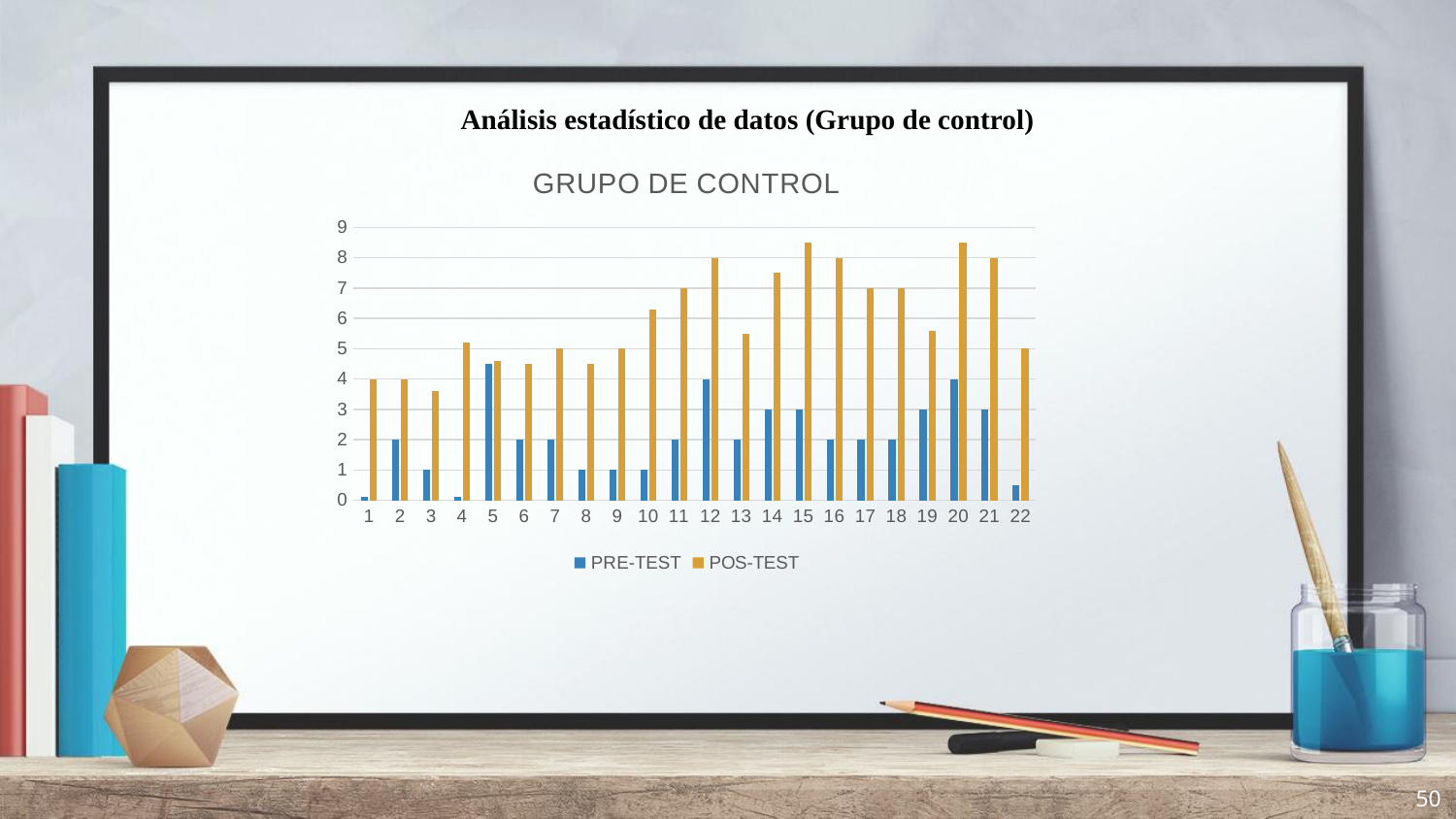
Is the POS-TEST value for category 15 greater or less than 8? greater How many categories are shown on the x axis of the GRUPO DE CONTROL chart? 22 Is the PRE-TEST value for category 1 greater or less than 1? less What is the POS-TEST value for category 12? 8 What is the PRE-TEST value for category 12? 4 What is the difference between the POS-TEST and PRE-TEST values for category 12? 4 What is the POS-TEST value for category 1? 4 How many series does the legend of the GRUPO DE CONTROL chart list? 2 What kind of chart is shown on the slide? bar chart Which has the larger POS-TEST value, category 20 or category 3? category 20 Which category has the lowest POS-TEST value? 3 What are the two series named in the legend of the chart? PRE-TEST and POS-TEST